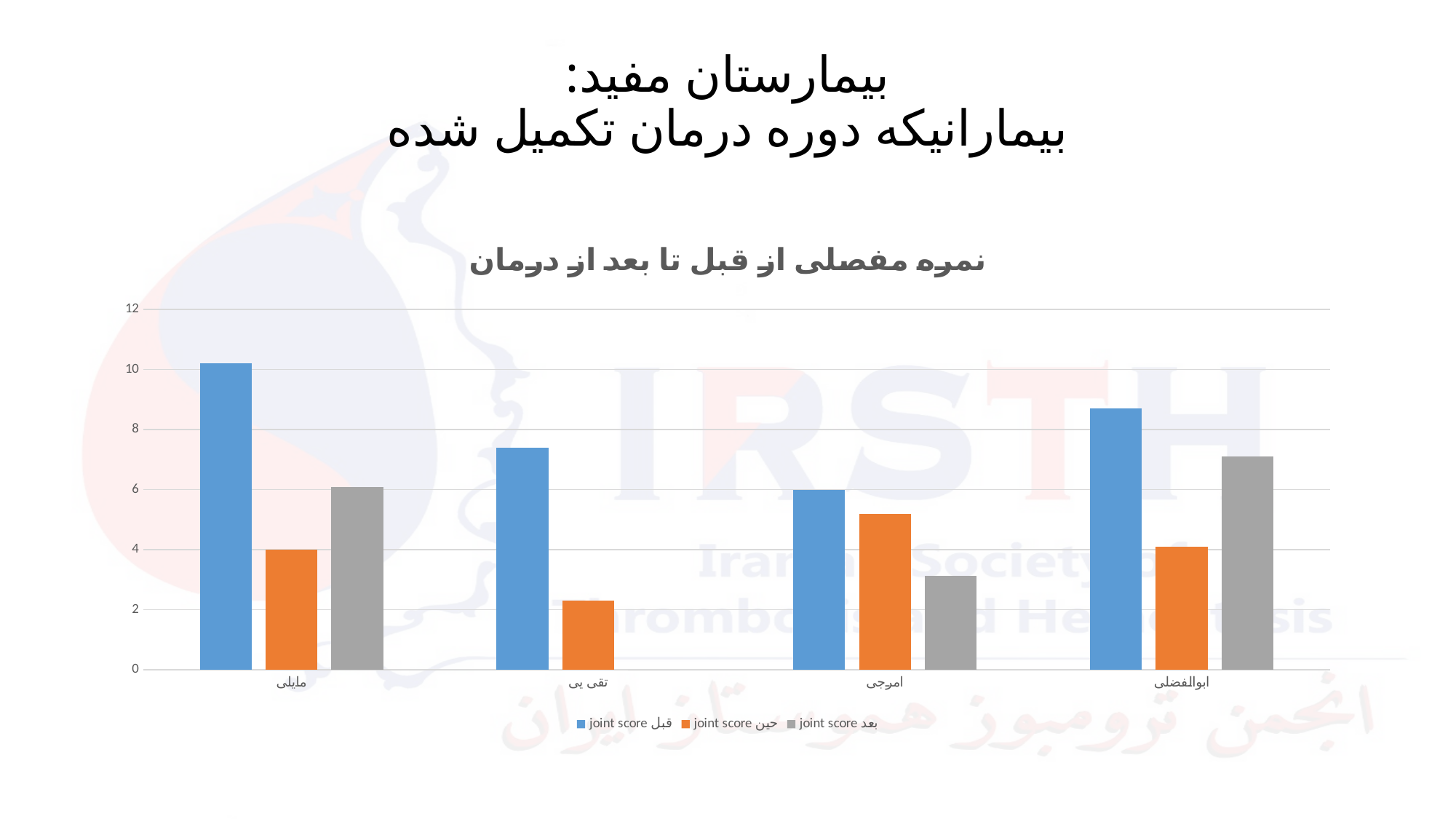
Which category has the lowest value for the 'joint score حین' series? تقی یی For امیرجی, which is larger: 'joint score قبل' or 'joint score حین'? joint score قبل Is the 'joint score بعد' value for ابوالفضلی greater or less than 6? greater Is the 'joint score قبل' value for ملیلی greater or less than 10? greater How many series does the chart legend list? 3 Which category has the highest value for the 'joint score بعد' series? ابوالفضلی Is the 'joint score حین' value for تقی یی greater or less than 4? less Which category has the highest value for the 'joint score قبل' series? مایلی What kind of chart is shown on the slide? bar chart For ابوالفضلی, which is larger: 'joint score قبل' or 'joint score بعد'? joint score قبل How many categories (patients) are shown on the x axis of the chart? 4 What is the title of the chart? نمره مفصلی از قبل تا بعد از درمان